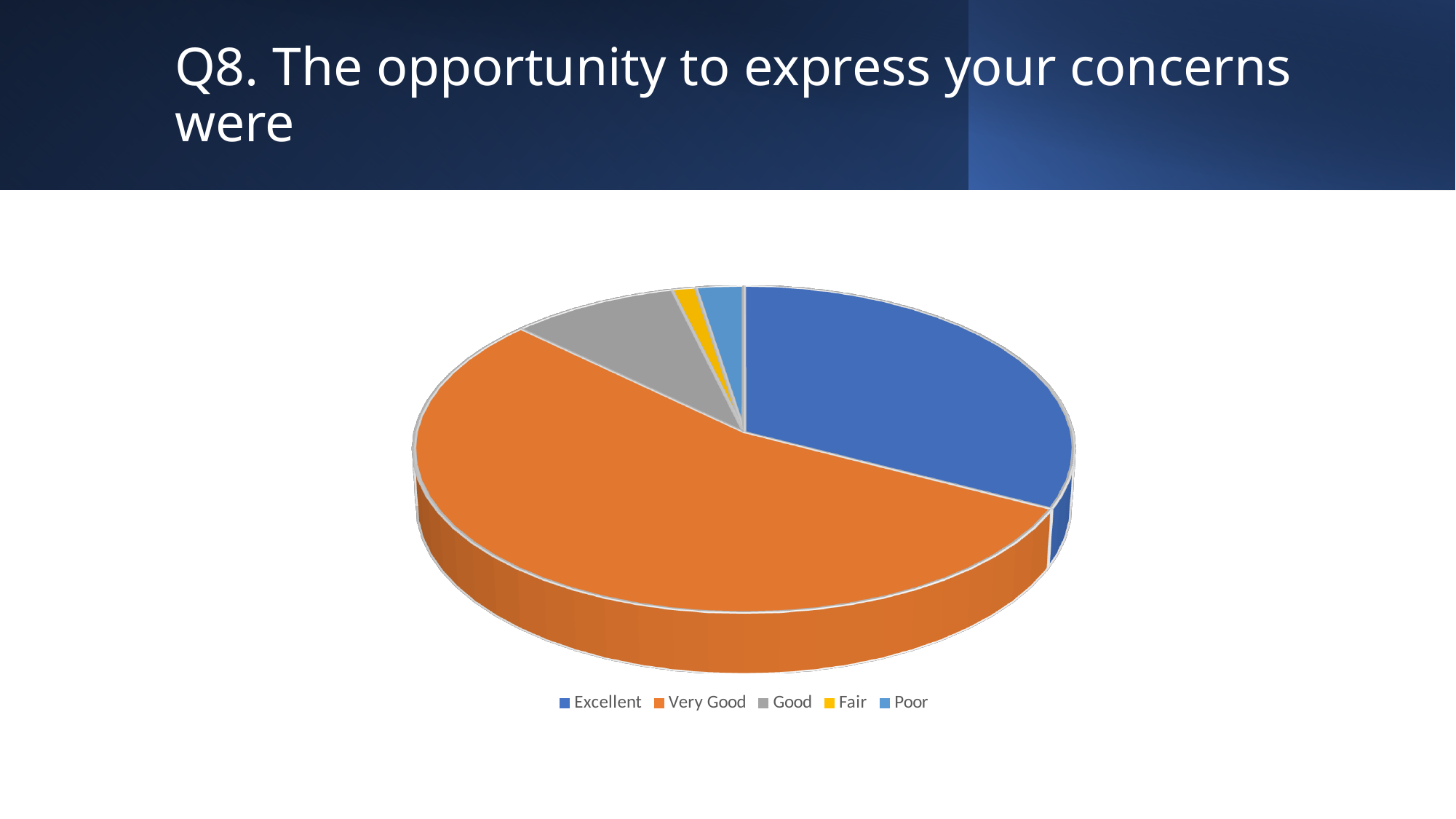
How many categories does the pie chart show? 5 Which category has the smallest slice of the pie? Fair What colour is the Very Good slice? Orange Which slice is larger, Good or Poor? Good Which slice is larger, Excellent or Very Good? Very Good Which slice is larger, Very Good or Good? Very Good What is the title of the slide? Q8. The opportunity to express your concerns were What kind of chart is shown on the slide? Pie chart Which category has the largest slice of the pie? Very Good How many entries does the legend list? 5